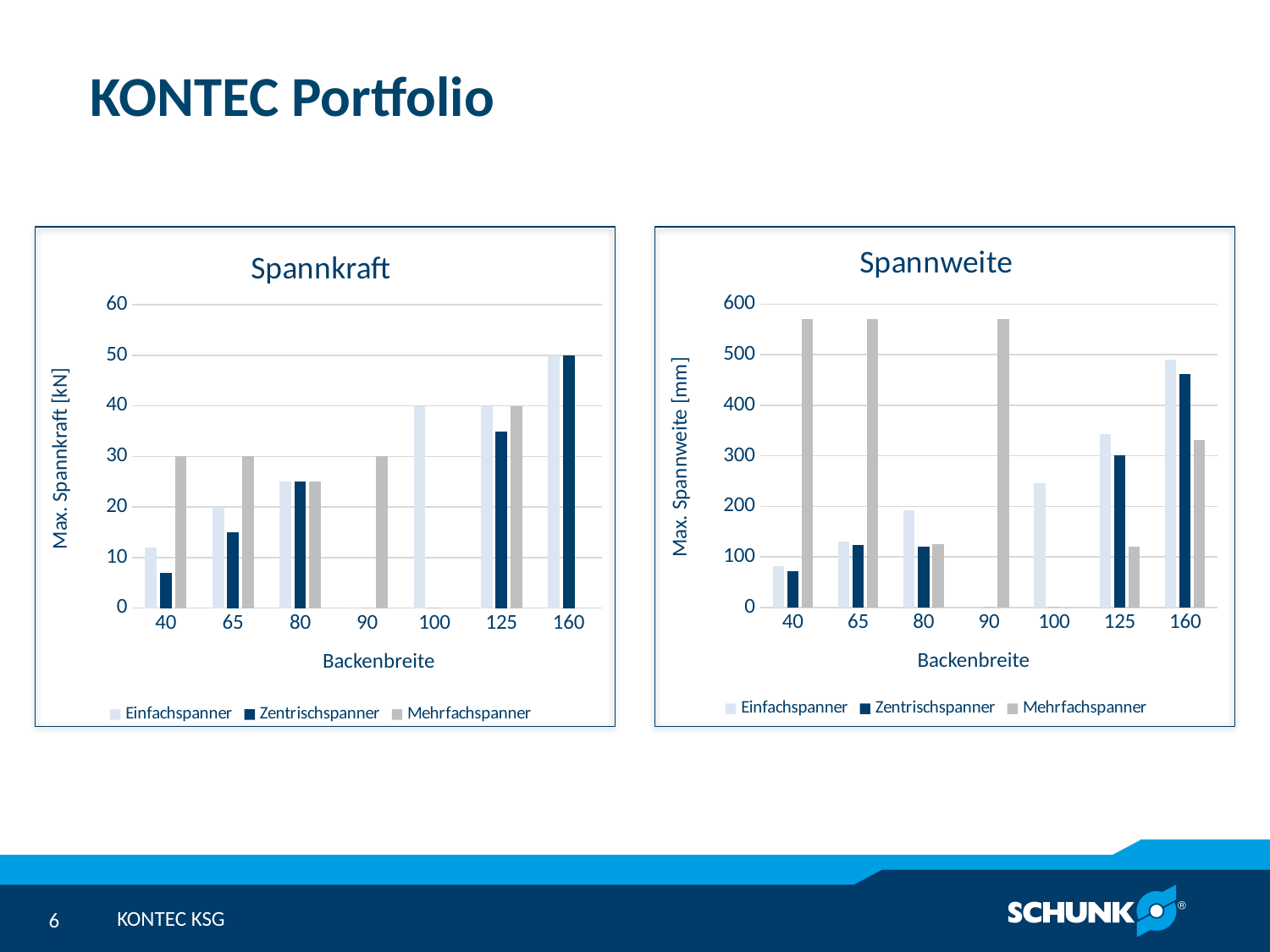
In the Spannweite chart, which series has the lowest value at Backenbreite 160? Mehrfachspanner In the Spannweite chart, is the value for Einfachspanner at Backenbreite 100 greater or less than 300? less In the Spannkraft chart, which series has the highest value at Backenbreite 65? Mehrfachspanner In the Spannkraft chart, what is the value for Mehrfachspanner at Backenbreite 40? 30 In the Spannweite chart, is the value for Mehrfachspanner at Backenbreite 90 greater or less than 500? greater How many Backenbreite categories are shown on the x axis of the Spannkraft chart? 7 What is the y-axis label of the Spannweite chart? Max. Spannweite [mm] How many series does the legend of the Spannweite chart list? 3 In the Spannkraft chart, what is the value for Einfachspanner at Backenbreite 100? 40 In the Spannkraft chart, what is the value for Zentrischspanner at Backenbreite 160? 50 What type of chart is the Spannkraft chart? bar chart